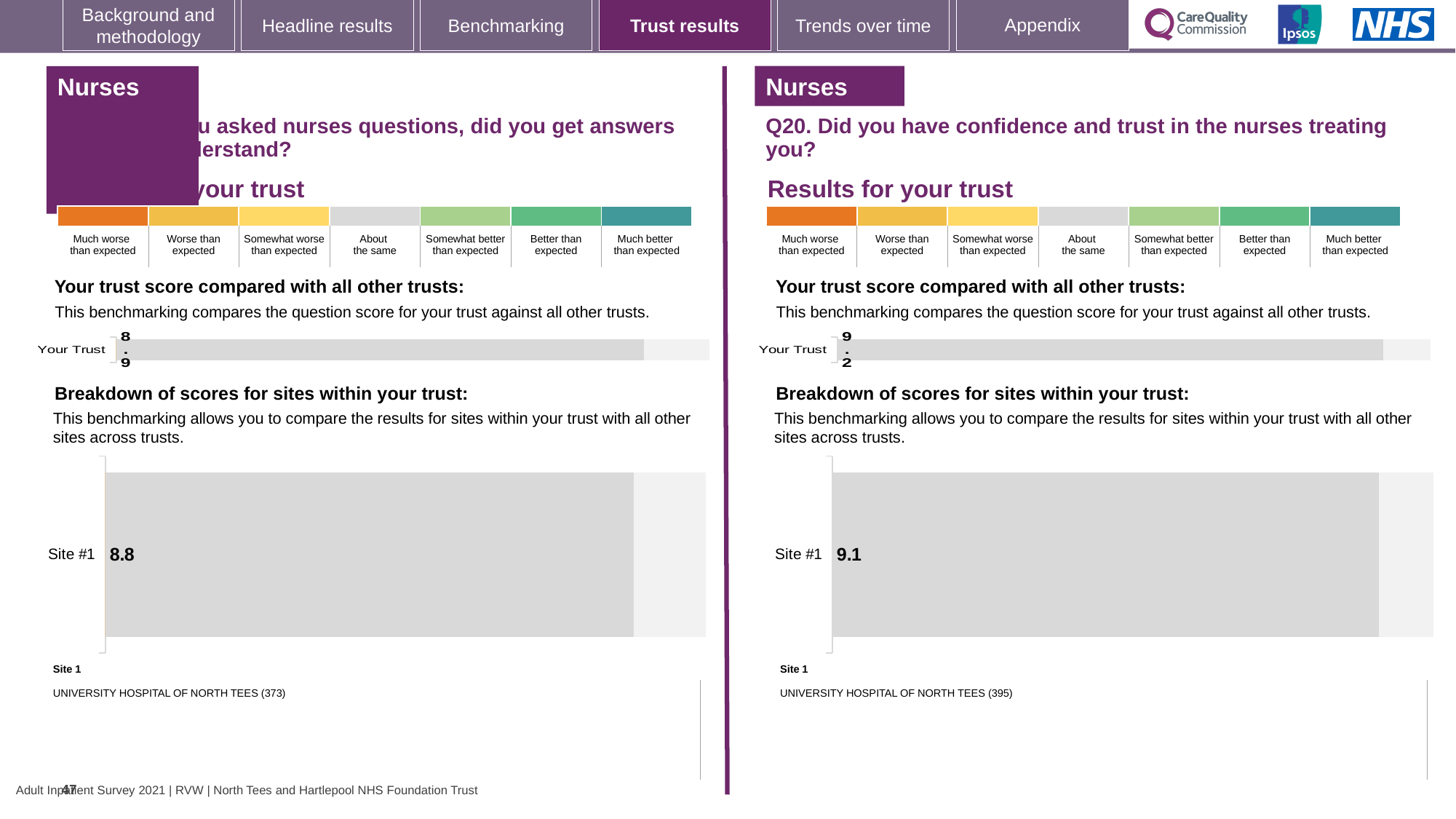
What is the title of the question shown on the right half of the slide? Q20. Did you have confidence and trust in the nurses treating you? What is the difference between the Your Trust score (8.9) and the Site #1 score (8.8) on the left half of the slide? 0.1 How many sites are shown in the left 'Breakdown of scores for sites within your trust' chart? 1 Which is larger on the left half of the slide: the Your Trust score or the Site #1 score? Your Trust What is the difference between the Your Trust score (9.2) and the Site #1 score (9.1) on the right half of the slide? 0.1 Which site is listed as Site 1 below the right-hand breakdown chart? UNIVERSITY HOSPITAL OF NORTH TEES (395) In the right 'Breakdown of scores for sites within your trust' chart (Q20), what is the score for Site #1? 9.1 What type of chart is used to show the Site #1 score on the right half of the slide? Bar chart In the left 'Breakdown of scores for sites within your trust' chart, what is the score for Site #1? 8.8 Which is larger: the Your Trust score on the left half of the slide or the Your Trust score on the right half (Q20)? Right half (Q20) On the right half of the slide (Q20), what is the score shown for Your Trust in the 'Your trust score compared with all other trusts' chart? 9.2 On the left half of the slide, what is the score shown for Your Trust in the 'Your trust score compared with all other trusts' chart? 8.9